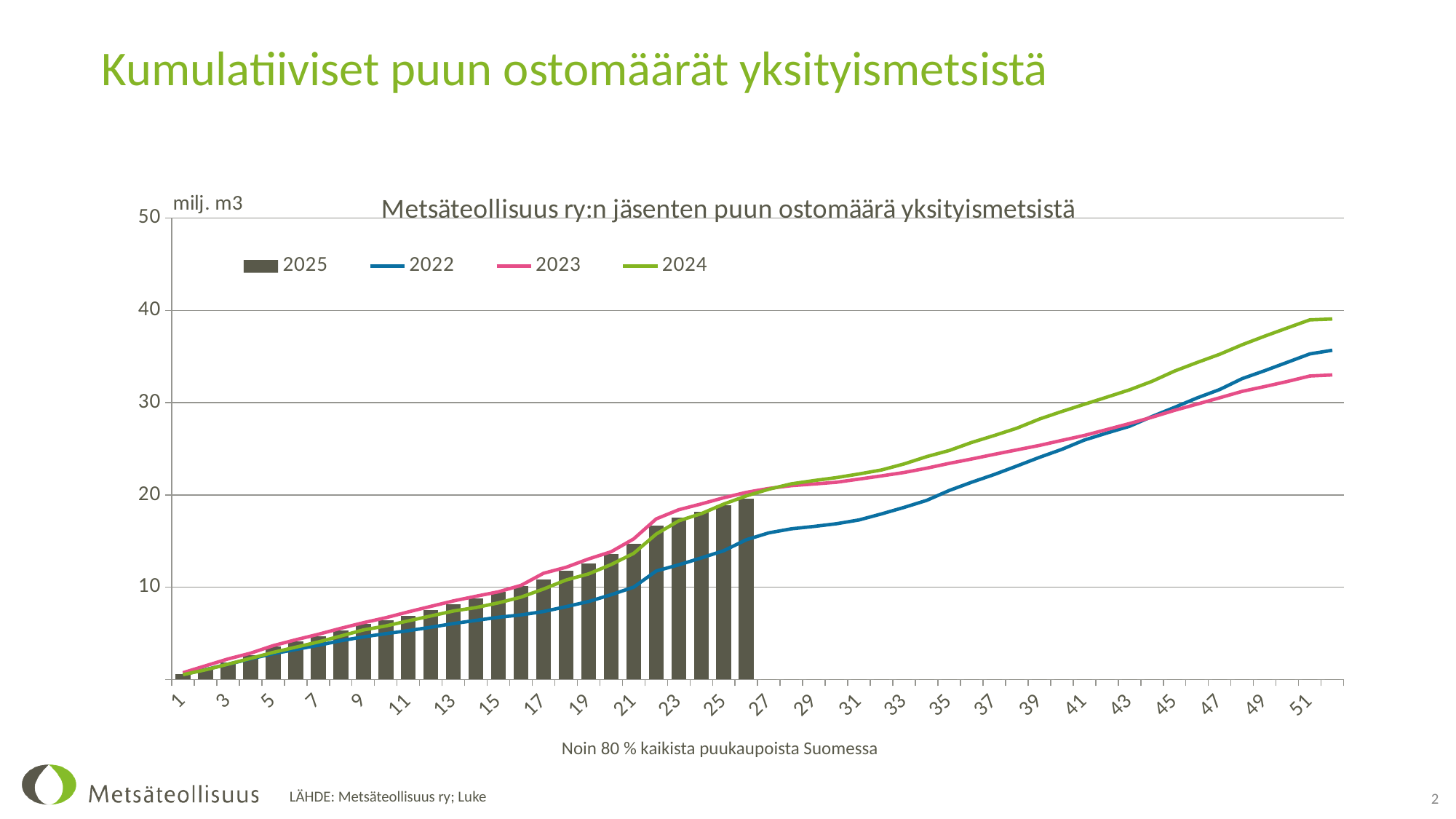
Do the values of the 2024 line rise or fall along the x axis? rise At week 31, which is higher, the 2023 line or the 2022 line? 2023 What is the title of the chart? Metsäteollisuus ry:n jäsenten puun ostomäärä yksityismetsistä Which series has the lowest value at week 51? 2023 Is the value of the 2024 line at week 51 greater or less than 35? greater Is the value of the 2022 line at week 29 greater or less than 20? less What kind of chart is shown on the slide? A combined bar and line chart How many series does the chart legend list? 4 Is the value of the 2023 line at week 51 greater or less than 35? less Which series has the highest value at week 51? 2024 Which series is drawn as bars rather than a line? 2025